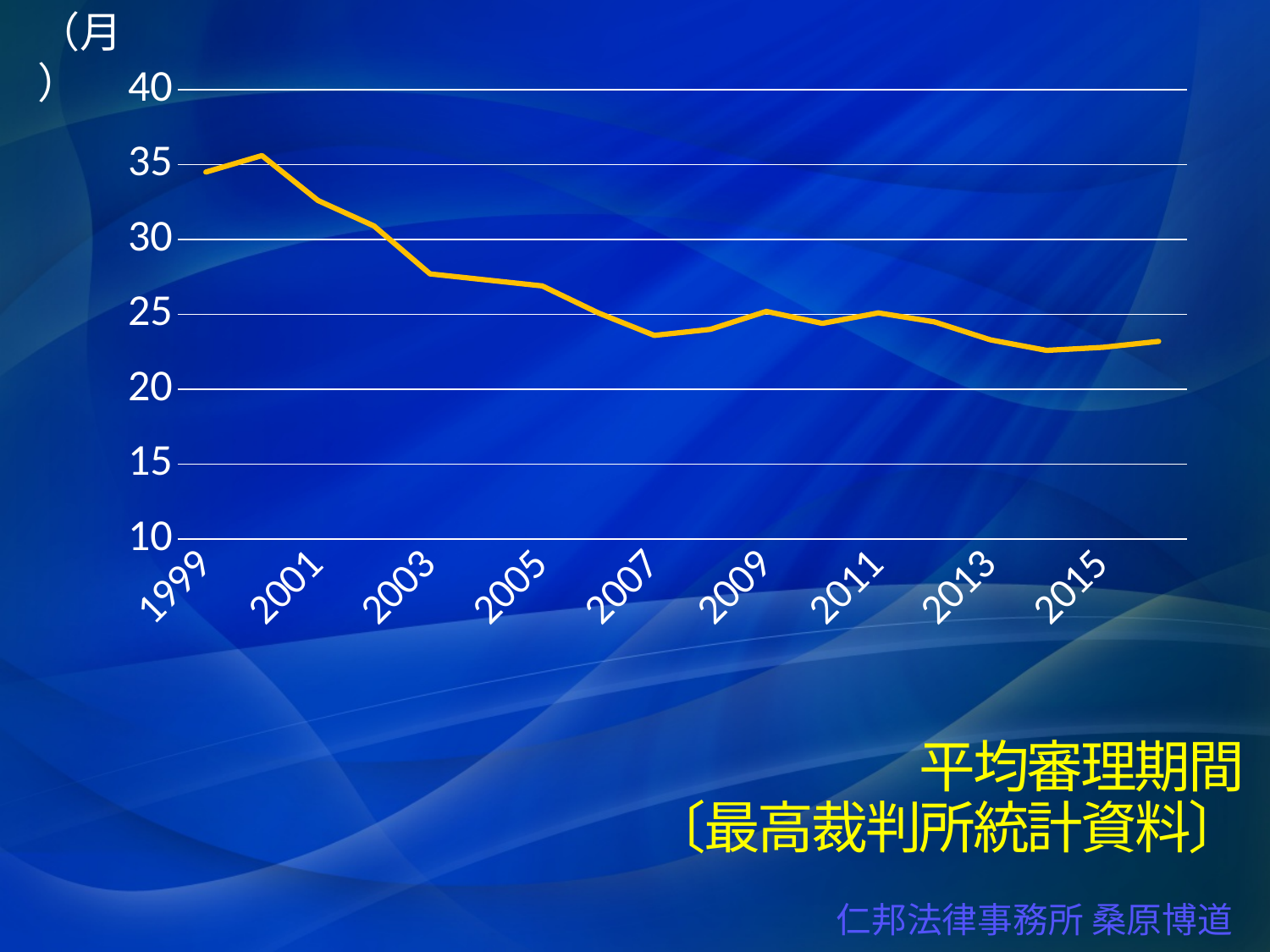
Is the value for 2011 greater or less than 30? less Is the value for 2003 greater or less than 30? less What kind of chart is shown on the slide? line chart Overall, do the values rise or fall from 1999 to 2015? fall Is the value for 2015 greater or less than 25? less What is the title of the chart? 平均審理期間〔最高裁判所統計資料〕 Which is larger, the value for 2003 or the value for 2007? 2003 How many year labels are shown on the x axis? 9 Which is larger, the value for 1999 or the value for 2015? 1999 What unit is indicated for the y axis? 月